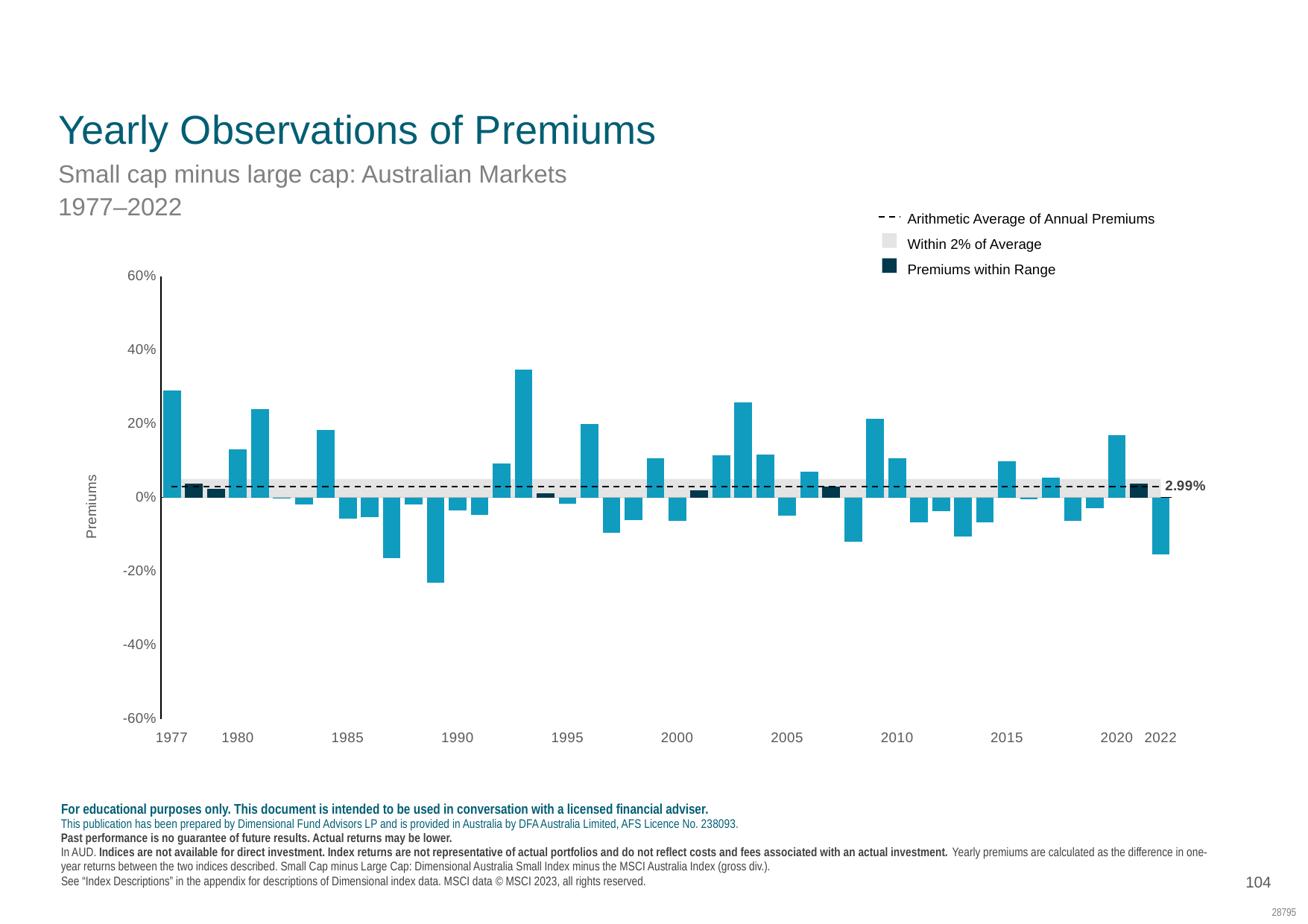
Is the premium for 1989 greater or less than -20%? less What kind of chart is shown on the slide? Bar chart Is the premium for 2022 greater or less than 0%? less Is the premium for 2020 greater or less than 0%? greater Which year has the lowest premium on the chart? 1989 What is the arithmetic average of annual premiums shown on the chart? 2.99% What is the title of the chart on the slide? Yearly Observations of Premiums Which year has the highest premium on the chart? 1993 How many entries does the chart legend list? 3 Which year has the larger premium, 1977 or 1980? 1977 How many years are covered by the chart? 46